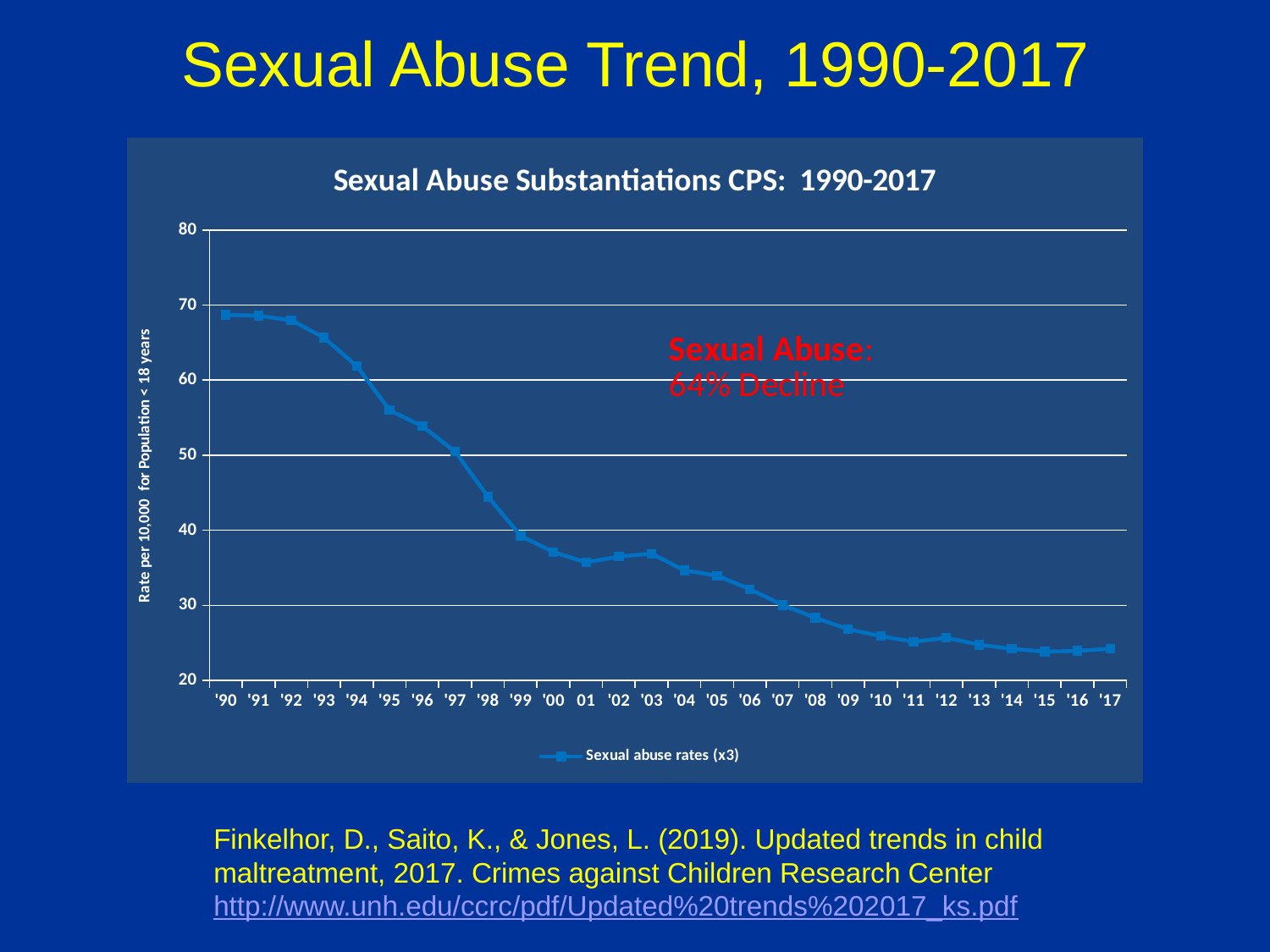
Which year has the larger sexual abuse rate, '90 or '17? '90 Is the value for '90 greater or less than 60? greater Is the value for '95 greater or less than 60? less Is the value for '00 greater or less than 40? less What kind of chart is shown on the slide? line chart What is the name of the series shown in the legend? Sexual abuse rates (x3) How many series does the legend list? 1 What is the title of the chart? Sexual Abuse Substantiations CPS: 1990-2017 How many years are plotted along the x axis? 28 Do the sexual abuse rates generally rise or fall from '90 to '17? fall